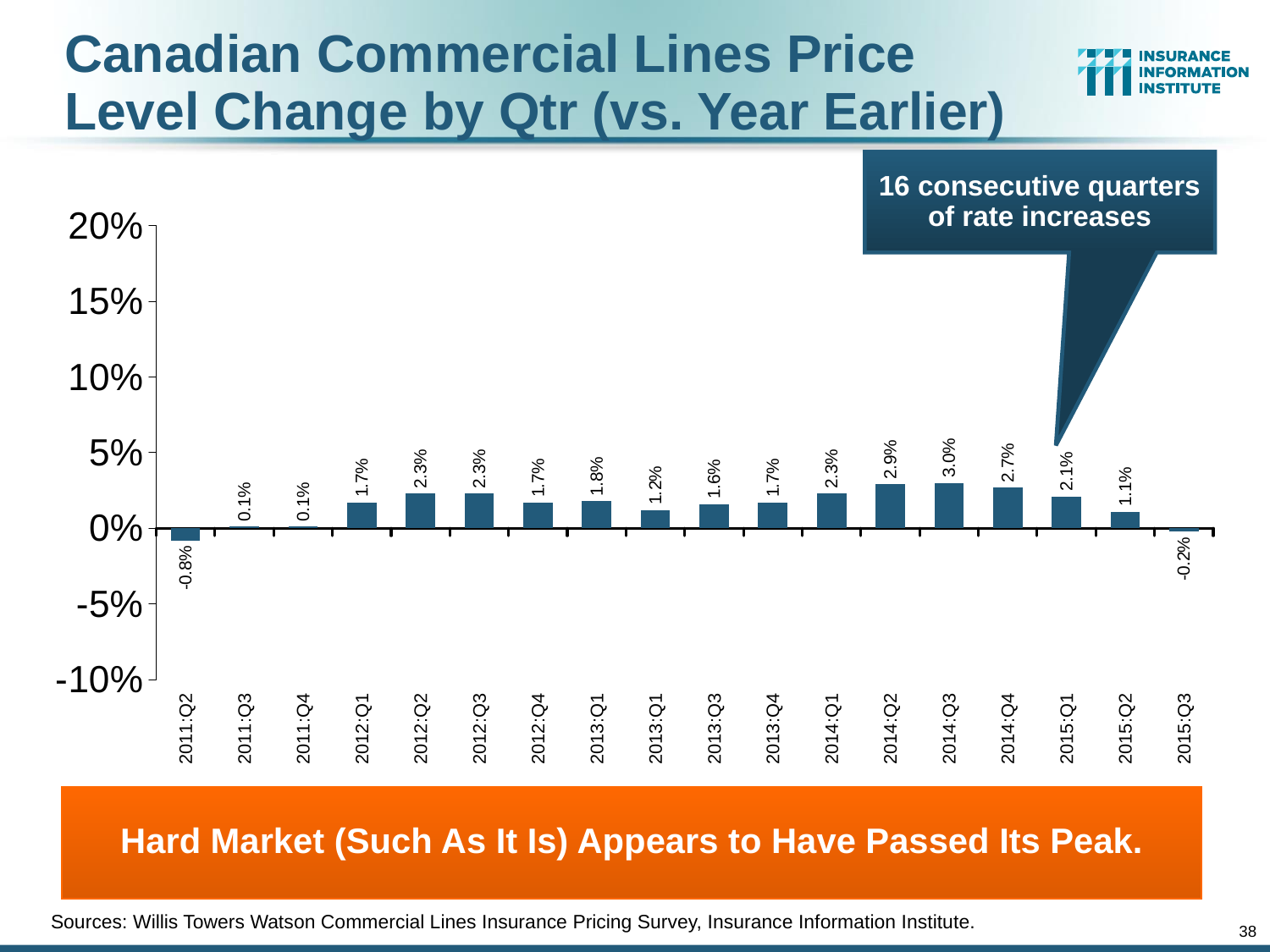
What kind of chart is shown on the slide? Bar chart What is the difference between the values for 2014:Q3 and 2015:Q2? 1.9% Which quarter has the lowest price level change? 2011:Q2 Is the value for 2014:Q3 greater or less than 5%? less What is the value shown for 2011:Q2? -0.8% Which is larger, the value for 2014:Q4 or the value for 2015:Q1? 2014:Q4 According to the callout on the chart, how many consecutive quarters of rate increases were there? 16 How many quarters are plotted on the chart? 18 Which quarter has the highest price level change? 2014:Q3 What is the price level change shown for 2014:Q3? 3.0% What is the value shown for 2014:Q2? 2.9% What is the value shown for 2015:Q3? -0.2%